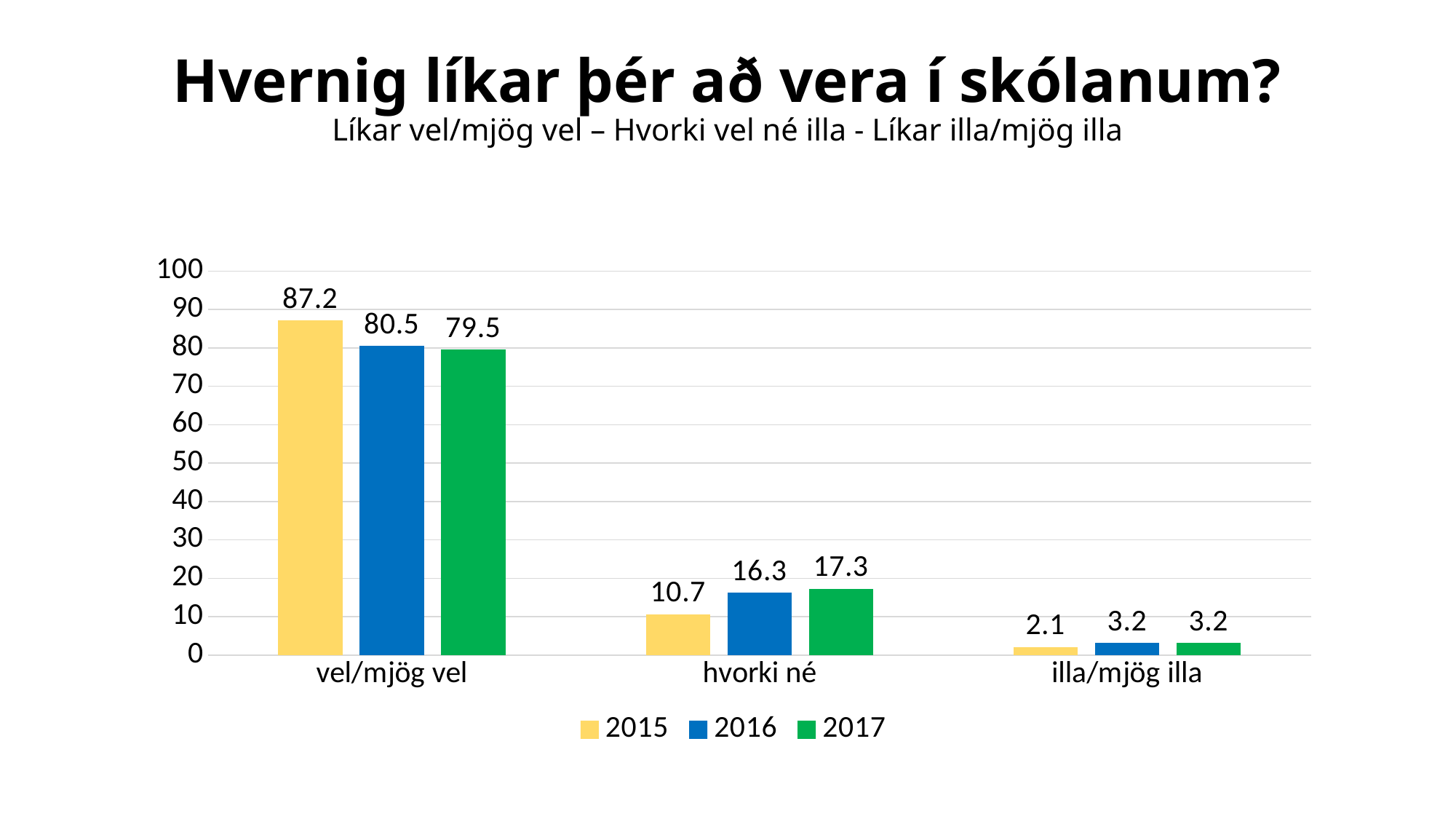
What is the value for 2015 in the "vel/mjög vel" category? 87.2 What is the value for 2017 in the "hvorki né" category? 17.3 What kind of chart is shown on the slide? bar chart What is the difference between the 2015 and 2017 values in the "vel/mjög vel" category? 7.7 Which is larger: the 2016 value or the 2017 value in the "hvorki né" category? 2017 How many series does the legend list? 3 How many categories are shown on the x axis? 3 What is the difference between the 2016 and 2015 values in the "hvorki né" category? 5.6 Which colour represents the 2016 series in the chart? blue Which year has the highest value in the "vel/mjög vel" category? 2015 Which year has the lowest value in the "hvorki né" category? 2015 What is the value for 2016 in the "illa/mjög illa" category? 3.2